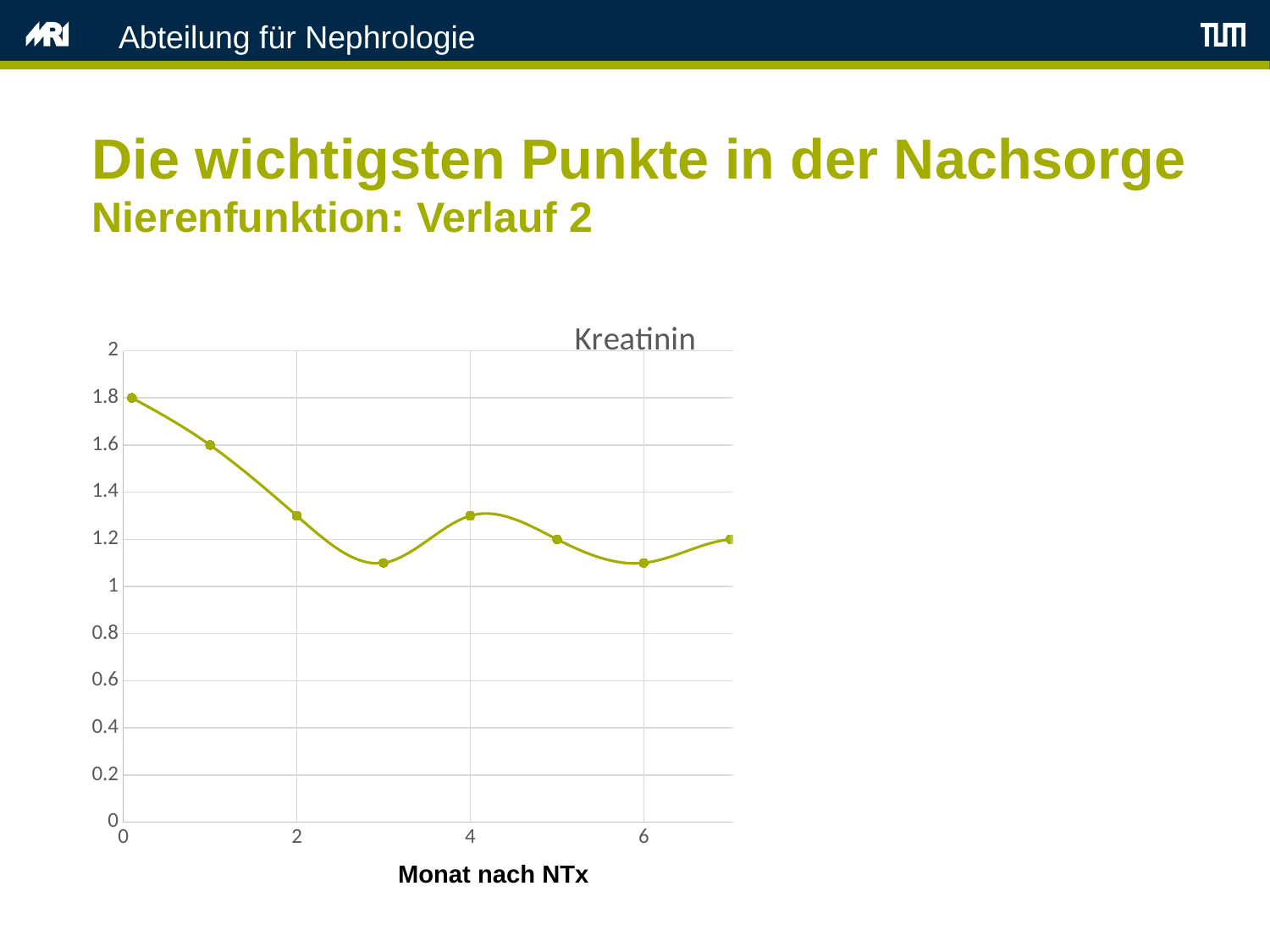
What is the Kreatinin value at month 0? 1.8 Is the Kreatinin value at month 2 greater or less than 1.4? less What is the Kreatinin value at month 1? 1.6 At which month is the Kreatinin value highest? 0 How many data points are plotted on the Kreatinin line? 8 Is the Kreatinin value at month 4 greater or less than 1.2? greater What is the label of the x axis? Monat nach NTx What is the title of the chart? Kreatinin What type of chart is shown on the slide? line chart Does the Kreatinin value rise or fall from month 0 to month 3? fall Is the Kreatinin value at month 3 greater or less than 1.2? less Which is larger, the Kreatinin value at month 0 or at month 4? month 0